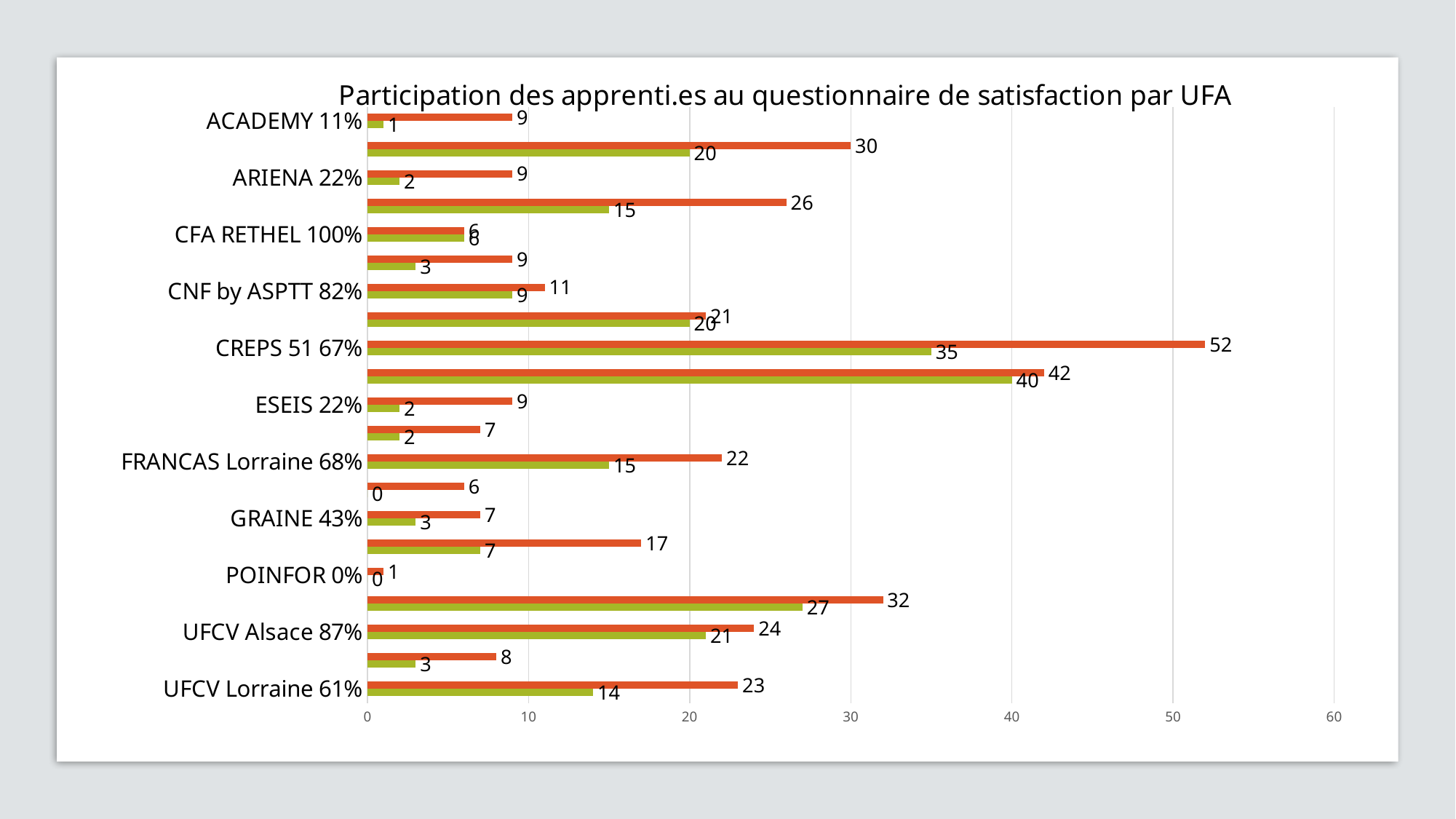
What is the value of the green bar for CREPS 51 67%? 35 What is the value of the green bar for POINFOR 0%? 0 What type of chart is shown on the slide? bar chart Which is larger, the orange bar for UFCV Alsace 87% or the orange bar for UFCV Lorraine 61%? UFCV Alsace 87% What is the title of the chart? Participation des apprenti.es au questionnaire de satisfaction par UFA What is the value of the green bar for FRANCAS Lorraine 68%? 15 What is the value of the orange bar for CREPS 51 67%? 52 Is the orange bar value for CREPS 51 67% greater or less than 50? greater Which labelled category has the highest orange bar value? CREPS 51 67% What is the difference between the orange and green bar values for CREPS 51 67%? 17 What is the value of the orange bar for UFCV Lorraine 61%? 23 Which labelled category has the lowest orange bar value? POINFOR 0%